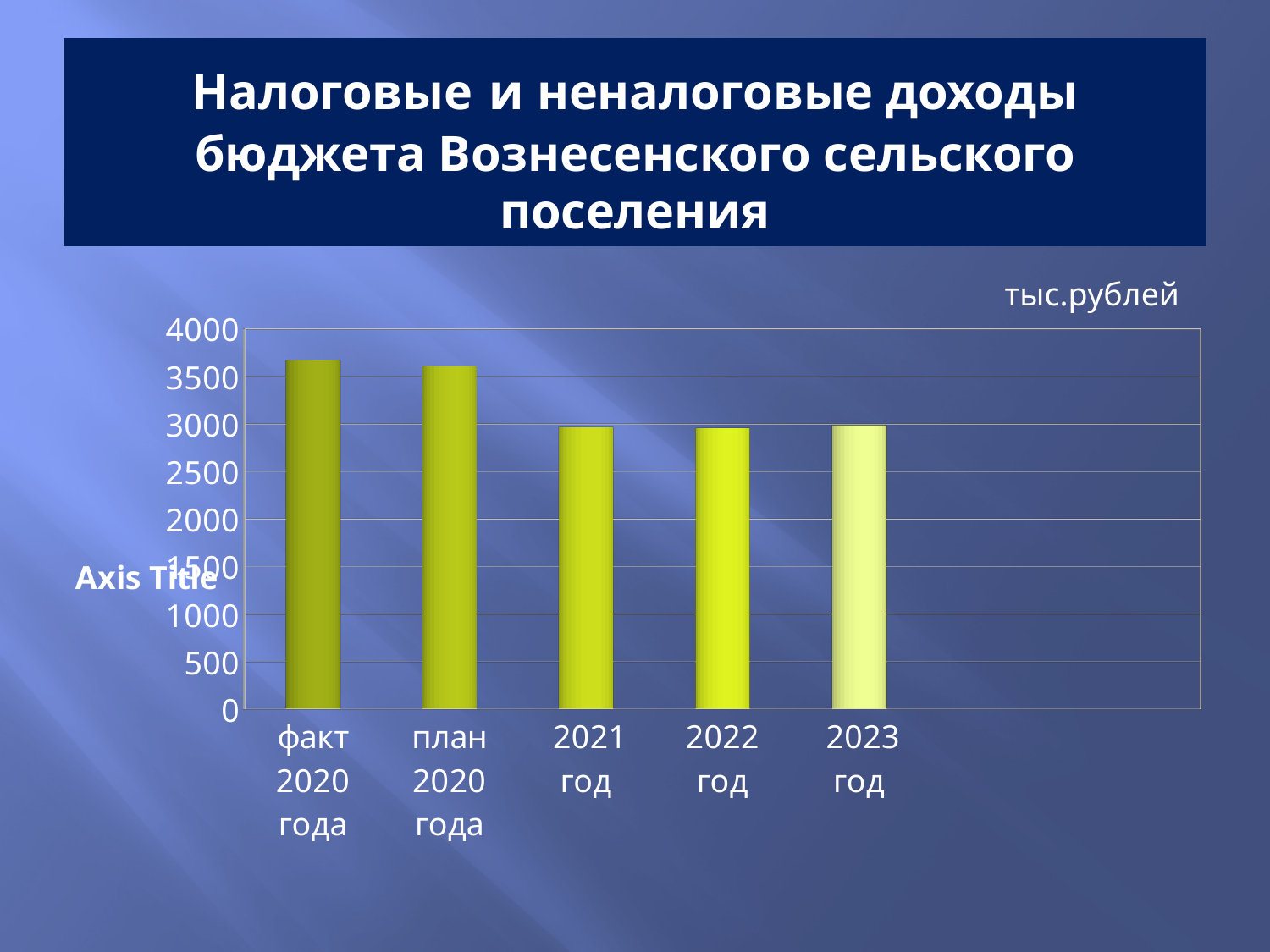
How many categories are shown on the x axis of the chart? 5 Which is larger, the value for план 2020 года or the value for 2023 год? план 2020 года Is the value for 2022 год greater or less than 2500? greater Is the value for 2021 год greater or less than 3500? less What kind of chart is shown on the slide? bar chart Is the value for 2023 год greater or less than 3500? less Do the values generally rise or fall from факт 2020 года to 2023 год? fall Which is larger, the value for факт 2020 года or the value for 2021 год? факт 2020 года What is the title of the slide above the chart? Налоговые и неналоговые доходы бюджета Вознесенского сельского поселения What unit is indicated above the chart? тыс.рублей